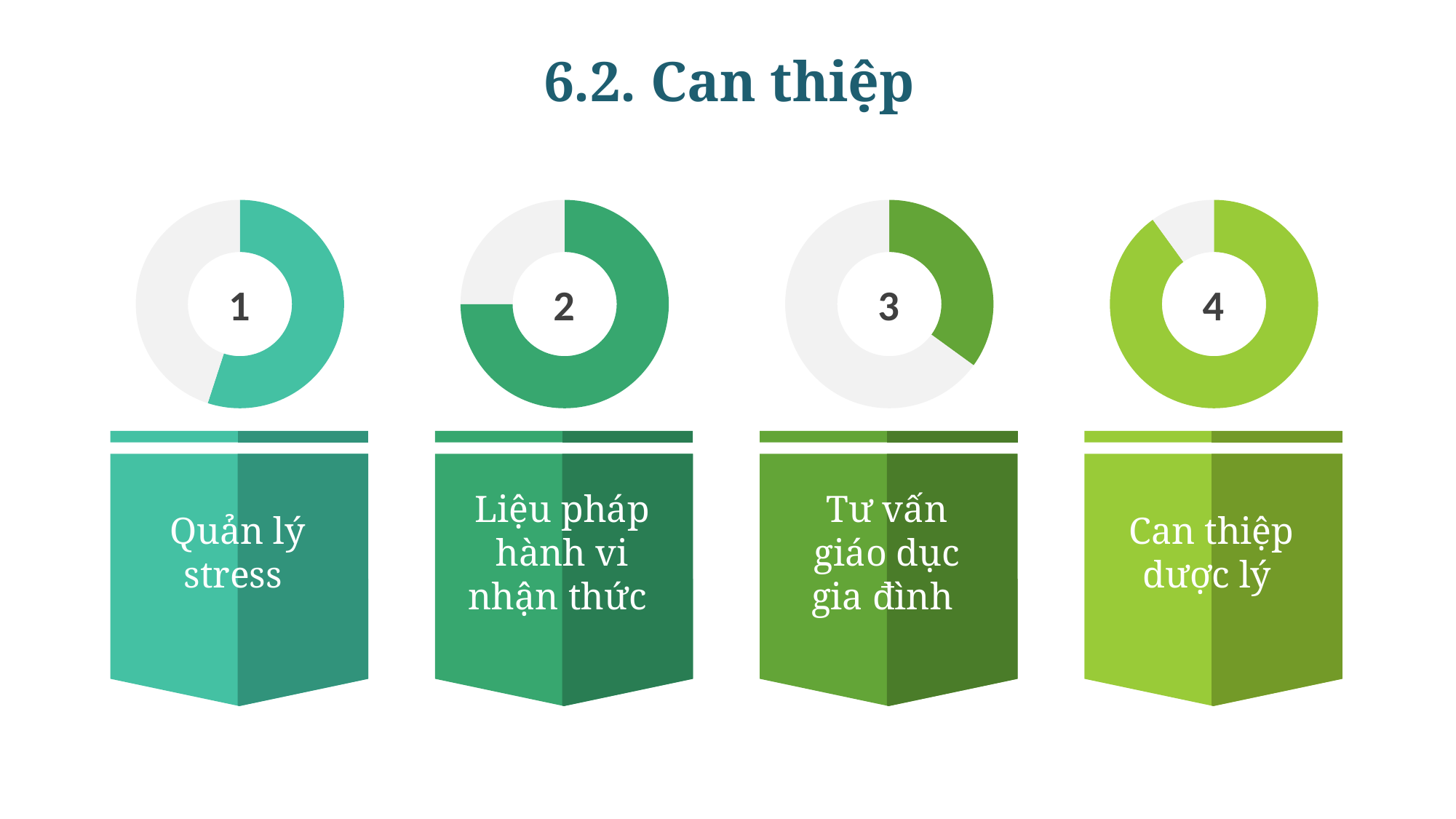
How many donut charts are shown on the slide? 4 What kind of chart is used for each of the four numbered items on the slide? Donut chart Which numbered donut chart has the largest coloured (filled) portion? 4 Which donut chart has a larger coloured portion, chart 2 or chart 3? Chart 2 What label appears below donut chart 1? Quản lý stress What label appears below donut chart 4? Can thiệp dược lý Which numbered donut chart has the smallest coloured (filled) portion? 3 Which donut chart has a larger coloured portion, chart 1 or chart 4? Chart 4